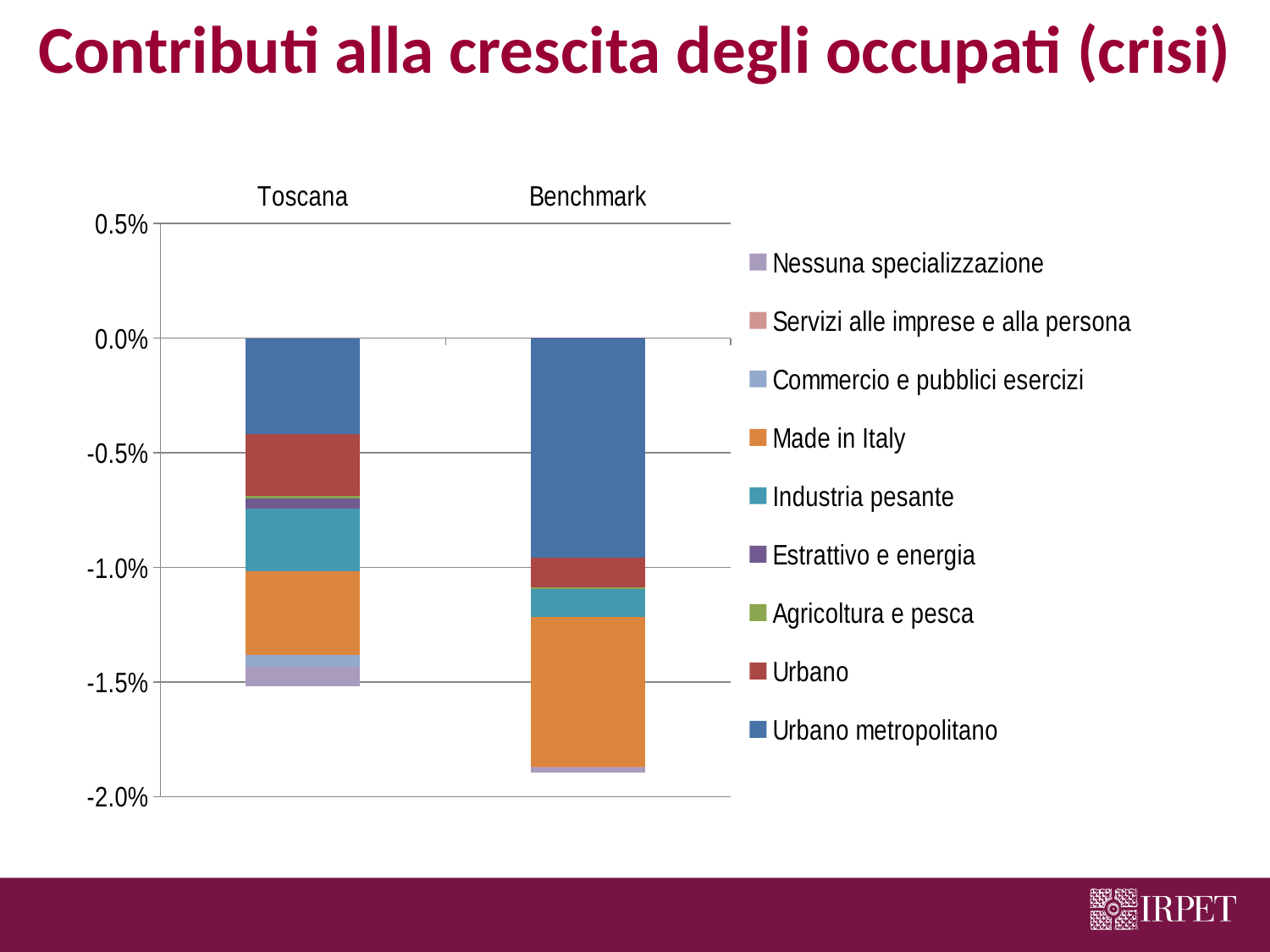
Is the total for the Benchmark bar greater or less than -1.5%? less Which series has the largest segment in the Benchmark bar? Urbano metropolitano Is the total for the Toscana bar greater or less than -1.0%? less What kind of chart is shown on the slide? Stacked bar chart Which series is shown in orange in the legend? Made in Italy How many series does the legend list? 9 Is the Urbano metropolitano contribution for Toscana greater or less than -0.5%? greater What is the title of the slide containing the chart? Contributi alla crescita degli occupati (crisi) Which category has the larger Made in Italy segment, Toscana or Benchmark? Benchmark How many categories (bars) does the chart show? 2 Which bar extends further below zero, Toscana or Benchmark? Benchmark Which category has the larger Urbano segment, Toscana or Benchmark? Toscana